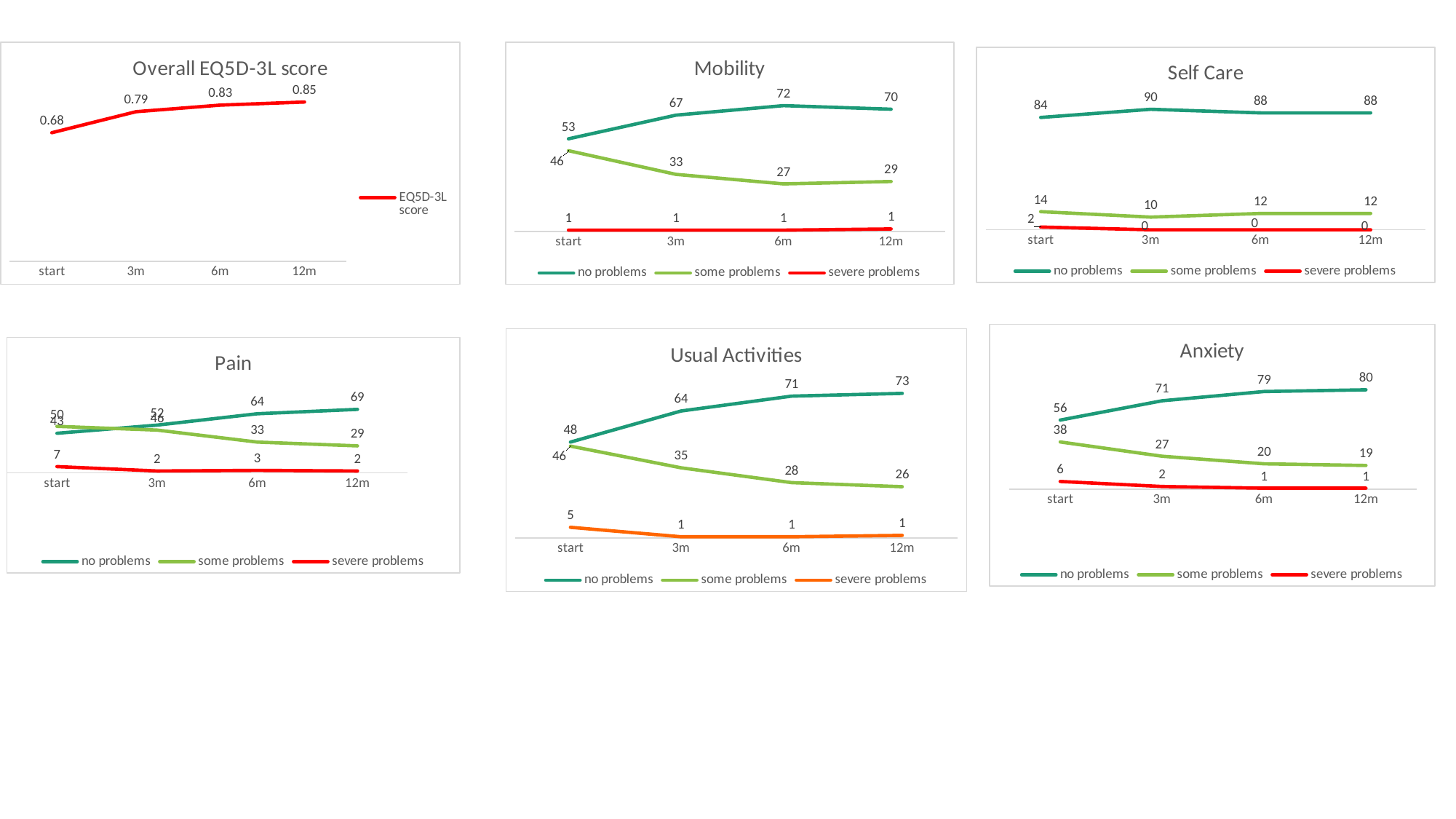
In the Mobility chart, what is the difference between no problems and some problems at 12m? 41 In the Anxiety chart, what is the difference between no problems at 12m and no problems at start? 24 In the Overall EQ5D-3L score chart, what is the value at start? 0.68 In the Pain chart, what is the value for severe problems at start? 7 In the Self Care chart, at which time point is no problems highest? 3m In the Mobility chart, what is the value for no problems at 6m? 72 In the Self Care chart, what is the value for some problems at start? 14 In the Overall EQ5D-3L score chart, what is the value at 12m? 0.85 In the Anxiety chart, how many series does the legend list? 3 In the Usual Activities chart, what is the value for some problems at 3m? 35 In the Usual Activities chart, which is larger at 6m: no problems or some problems? no problems In the Overall EQ5D-3L score chart, do the values rise or fall from start to 12m? rise